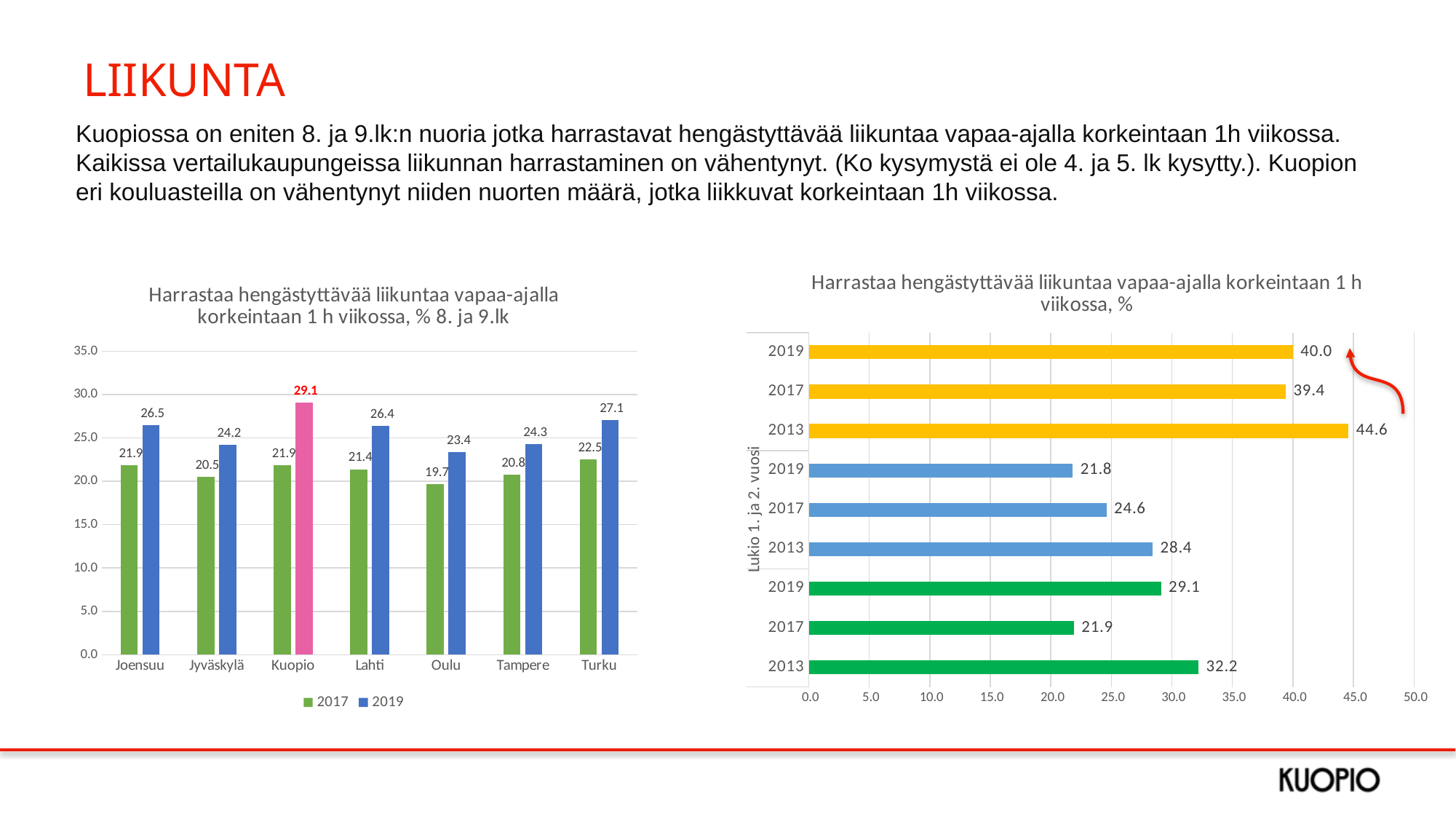
In the left chart, which is larger: the 2019 value for Turku or the 2019 value for Joensuu? Turku What type of chart is the right chart? Bar chart In the left chart, which city has the highest 2019 value? Kuopio In the left chart, what is the 2017 value for Oulu? 19.7 In the left chart, what is the 2019 value for Kuopio? 29.1 In the right chart, what is the value of the 2019 bar in the 'Lukio 1. ja 2. vuosi' group? 21.8 In the left chart, how many cities are shown on the x axis? 7 In the right chart, what is the value of the topmost yellow bar (2019)? 40.0 In the left chart, what is the difference between the 2019 and 2017 values for Kuopio? 7.2 In the right chart, what is the difference between the 2013 and 2019 values in the 'Lukio 1. ja 2. vuosi' group? 6.6 In the left chart, which city has the lowest 2017 value? Oulu In the left chart, how many series does the legend list? 2